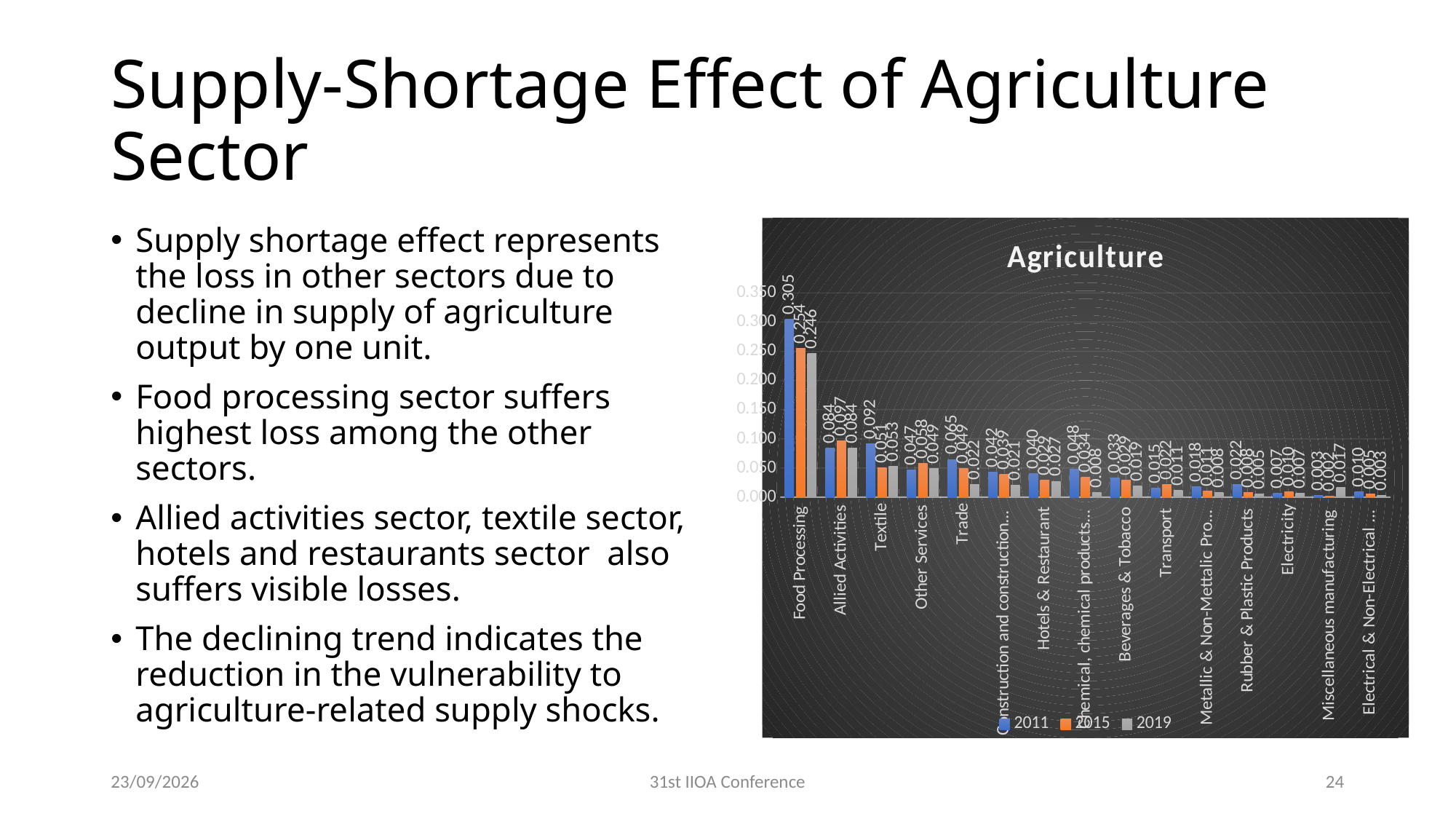
In the Agriculture chart, what is the 2019 value for Food Processing? 0.246 What kind of chart is shown on the slide? bar chart In the Agriculture chart, what is the 2015 value for Allied Activities? 0.097 In the Agriculture chart, what is the 2011 value for Trade? 0.065 In the Agriculture chart, is the 2015 value for Food Processing greater or less than 0.200? greater In the Agriculture chart, do the values for Food Processing rise or fall from 2011 to 2019? fall How many series does the legend of the Agriculture chart list? 3 Which sector has the highest 2011 value in the Agriculture chart? Food Processing In the Agriculture chart, what is the difference between the 2011 and 2015 values for Food Processing? 0.051 In the Agriculture chart, what is the 2011 value for Food Processing? 0.305 How many sectors are shown on the x axis of the Agriculture chart? 15 In the Agriculture chart, which has the larger 2011 value: Textile or Allied Activities? Textile